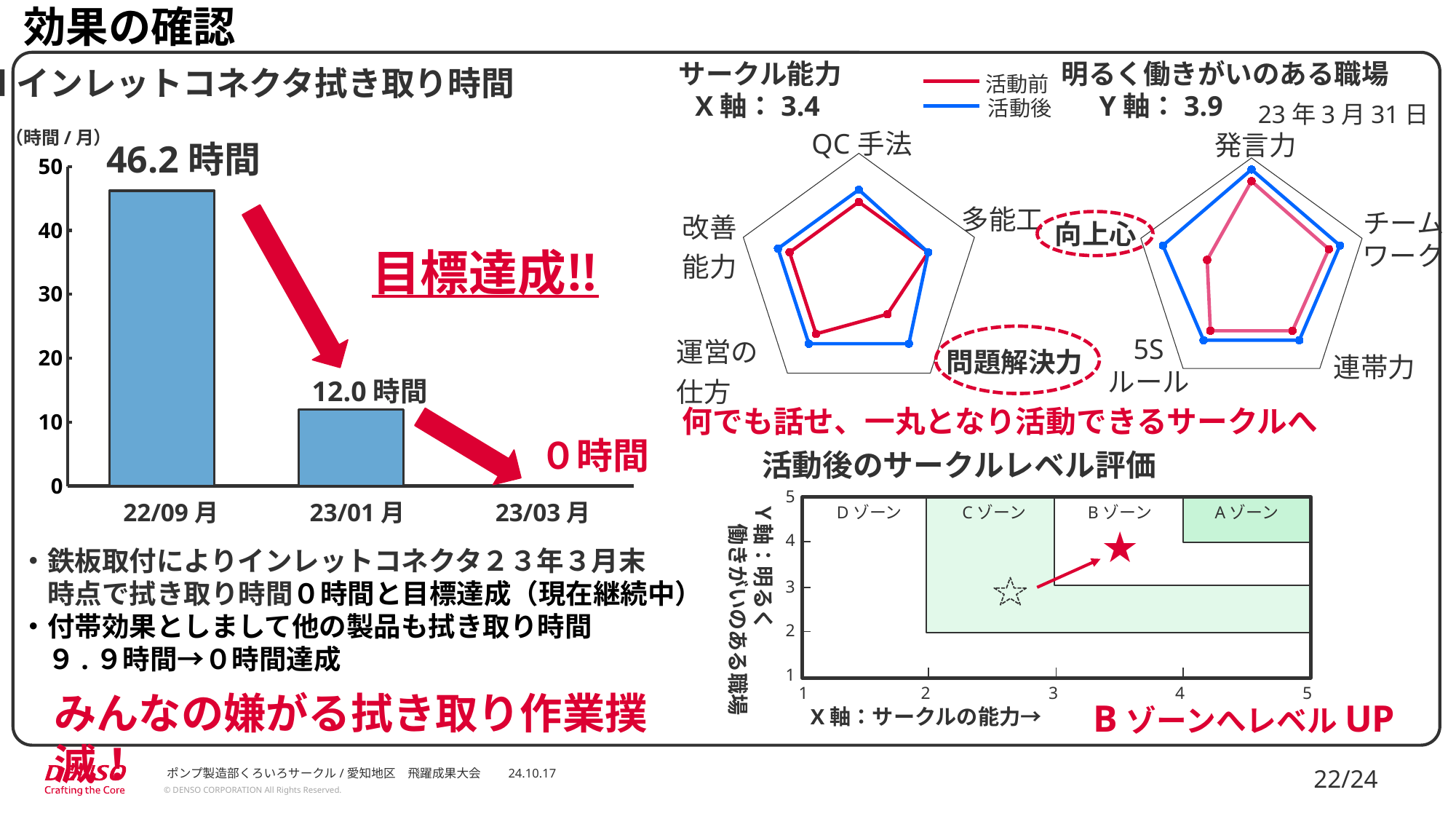
What kind of chart is インレットコネクタ拭き取り時間? bar chart In the bar chart インレットコネクタ拭き取り時間, what is the value for 23/03月? 0 時間 In the bar chart インレットコネクタ拭き取り時間, which month has the highest value? 22/09月 In the bar chart インレットコネクタ拭き取り時間, how many months are shown on the x axis? 3 In the bar chart インレットコネクタ拭き取り時間, what is the value for 22/09月? 46.2 時間 In the radar chart サークル能力, how many axes (categories) are there? 5 In the bar chart インレットコネクタ拭き取り時間, what is the difference between the values for 22/09月 and 23/01月? 34.2 時間 In the bar chart インレットコネクタ拭き取り時間, which month has the lowest value? 23/03月 In the bar chart インレットコネクタ拭き取り時間, what is the value for 23/01月? 12.0 時間 In the bar chart インレットコネクタ拭き取り時間, what unit is shown on the y axis? 時間/月 In the bar chart インレットコネクタ拭き取り時間, do the values rise or fall from 22/09月 to 23/03月? fall How many series does the legend of the radar charts (サークル能力 and 明るく働きがいのある職場) list? 2